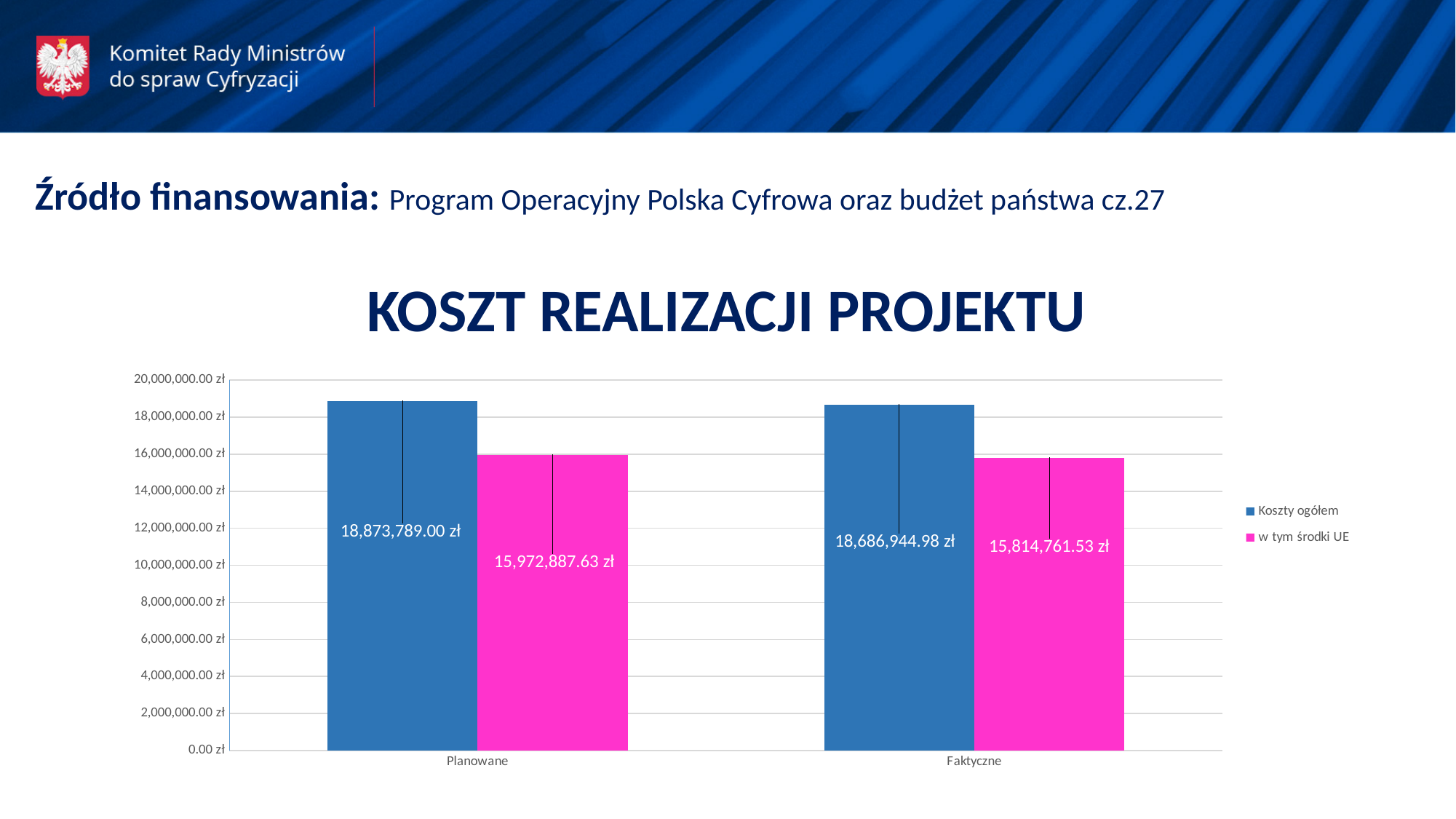
What is the difference between Koszty ogółem and w tym środki UE for Planowane? 2,900,901.37 zł What type of chart is shown on the slide? bar chart What is the value of w tym środki UE for Planowane? 15,972,887.63 zł How many series does the legend list? 2 Which series is shown in pink? w tym środki UE What is the value of Koszty ogółem for Planowane? 18,873,789.00 zł What is the title of the chart? KOSZT REALIZACJI PROJEKTU Which bar has the lowest value in the chart? w tym środki UE for Faktyczne Which bar has the highest value in the chart? Koszty ogółem for Planowane What is the value of w tym środki UE for Faktyczne? 15,814,761.53 zł How many categories are shown on the x axis? 2 What is the value of Koszty ogółem for Faktyczne? 18,686,944.98 zł